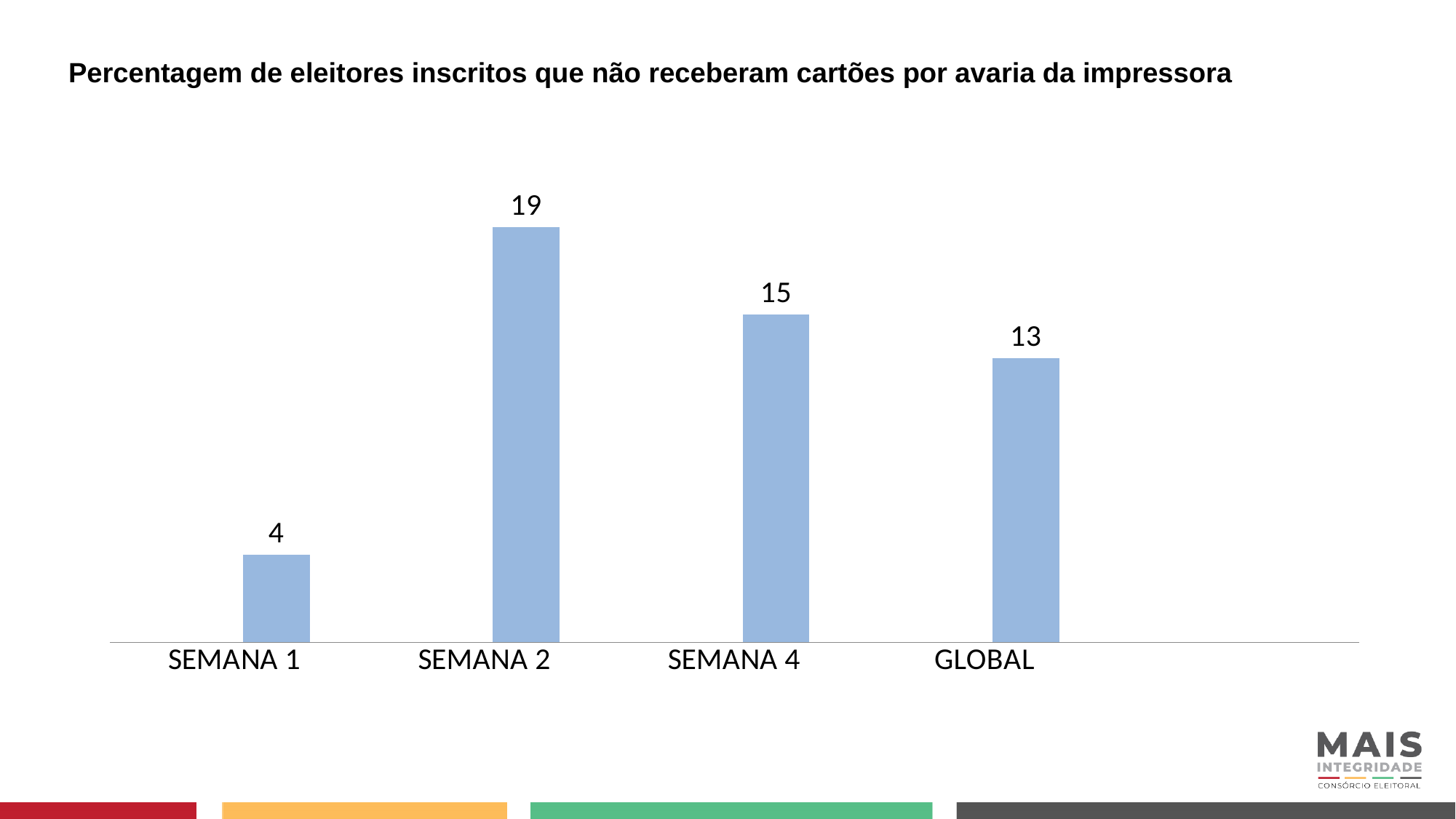
What is the difference between the values for SEMANA 4 and GLOBAL? 2 Which category has the lowest value? SEMANA 1 Which category has the highest value? SEMANA 2 What is the title of the chart? Percentagem de eleitores inscritos que não receberam cartões por avaria da impressora Which is larger, the value for SEMANA 4 or the value for GLOBAL? SEMANA 4 What is the value for SEMANA 4? 15 What kind of chart is shown on the slide? Bar chart What is the difference between the values for SEMANA 2 and SEMANA 1? 15 How many categories are shown on the x axis? 4 What is the value for GLOBAL? 13 What is the value for SEMANA 2? 19 What is the value for SEMANA 1? 4